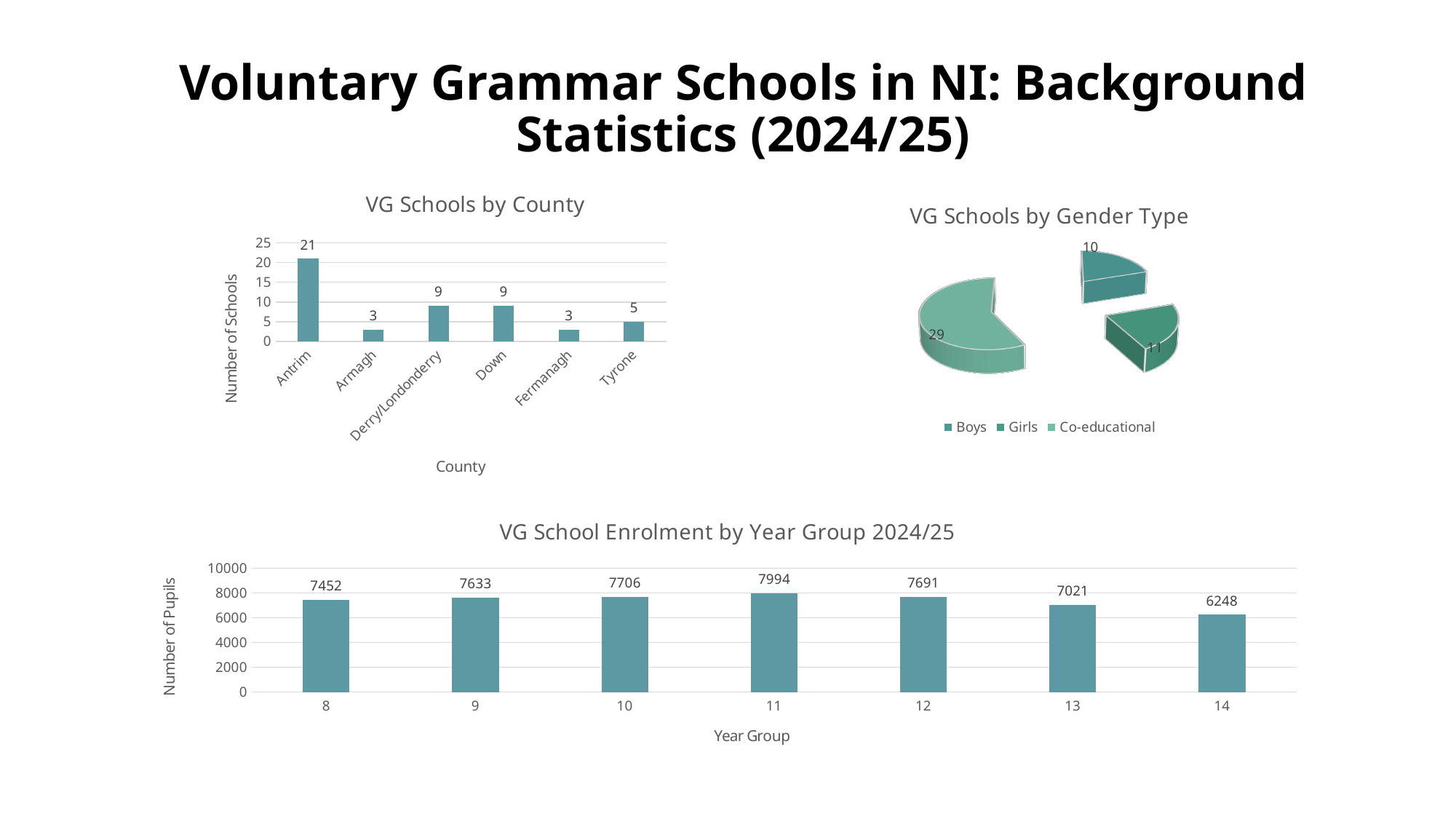
In the 'VG Schools by Gender Type' chart, how many schools are co-educational? 29 In the 'VG Schools by County' chart, how many schools are in Antrim? 21 In the 'VG Schools by County' chart, which county has the fewest schools? Armagh and Fermanagh (3 each) In the 'VG School Enrolment by Year Group 2024/25' chart, which year group has the highest enrolment? 11 In the 'VG Schools by Gender Type' chart, what is the total number of schools across all three slices? 50 In the 'VG School Enrolment by Year Group 2024/25' chart, what is the enrolment for year group 13? 7021 In the 'VG Schools by County' chart, what is the difference between the number of schools in Antrim and Tyrone? 16 In the 'VG Schools by County' chart, how many counties are shown? 6 In the 'VG School Enrolment by Year Group 2024/25' chart, is the enrolment for year group 14 greater or less than 8000? less In the 'VG Schools by Gender Type' chart, what share of schools are girls' schools? 22% In the 'VG School Enrolment by Year Group 2024/25' chart, what is the difference in enrolment between year group 11 and year group 14? 1746 What kind of chart is 'VG Schools by Gender Type'? Pie chart